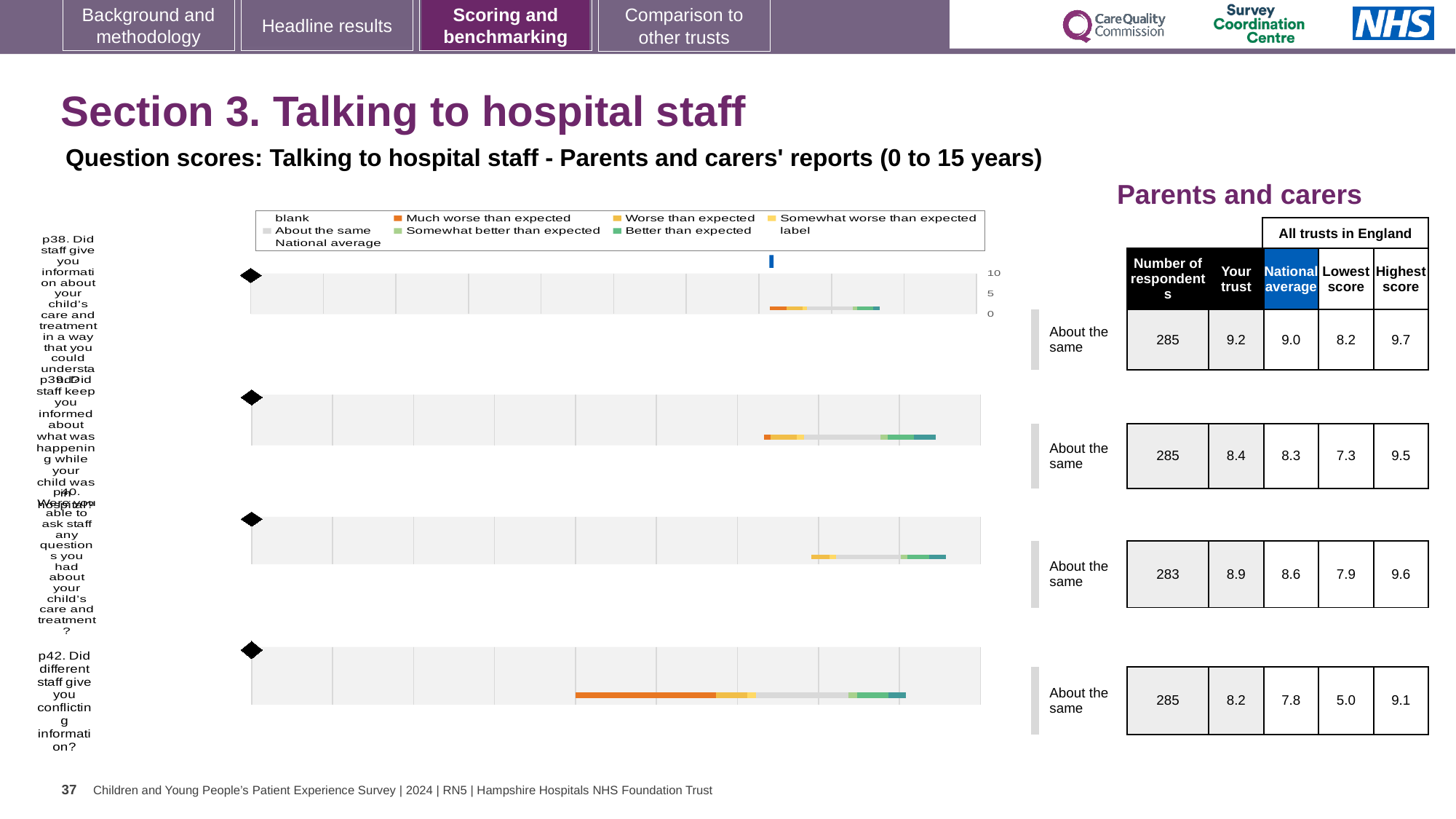
In the table beside the charts, how many respondents are listed for p40 (being able to ask staff any questions)? 283 In the table beside the charts, what is the Highest score among all trusts in England for p38? 9.7 In the table beside the charts, what is the 'Your trust' score for p38 (staff giving information about your child's care in a way you could understand)? 9.2 What benchmarking category label is shown next to the chart for p39 (staff keeping you informed about what was happening)? About the same Which question has the highest 'Your trust' score in the table beside the charts? p38 For p40, which is larger in the table beside the charts: the 'Your trust' score or the National average? Your trust Which question has the lowest 'Your trust' score in the table beside the charts? p42 What kind of chart is used to show the benchmarking results for each question on this slide? bar chart How many survey questions (p38, p39, p40, p42) are plotted as benchmarking bars on this slide? 4 In the table beside the charts, what is the National average score for p42 (different staff giving conflicting information)? 7.8 In the table beside the charts, what is the Lowest score among all trusts in England for p42? 5.0 For p38, how much higher is the 'Your trust' score than the National average in the table beside the charts? 0.2